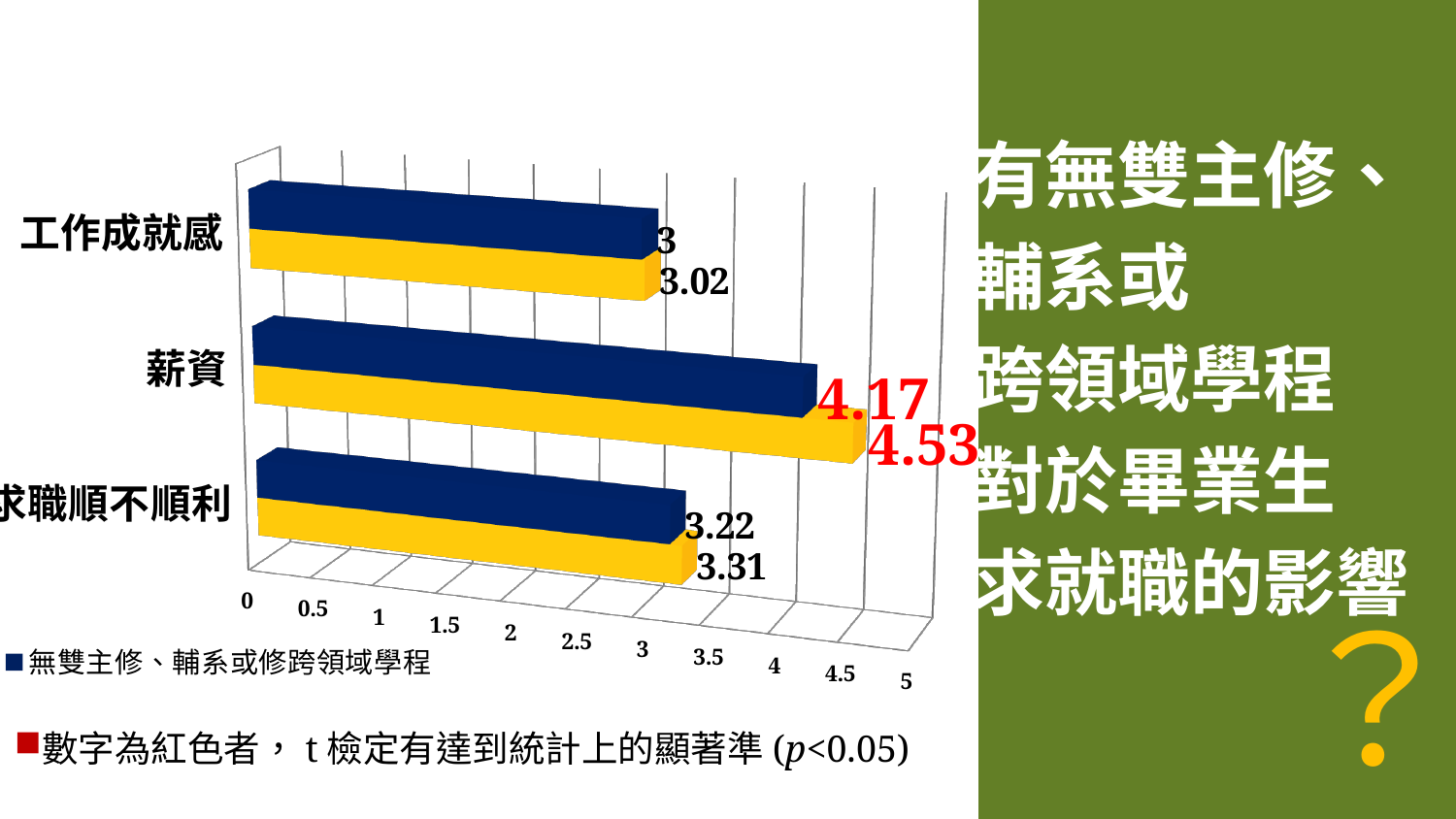
Which category has the highest value for the yellow series? 薪資 What is the value of the yellow bar for 求職順不順利? 3.31 What is the difference between the yellow bar and the dark blue bar for 薪資? 0.36 What is the value of the 無雙主修、輔系或修跨領域學程 (dark blue) bar for 薪資? 4.17 Which is larger for 求職順不順利: the dark blue bar or the yellow bar? the yellow bar How many categories are plotted on the chart? 3 What is the value of the 無雙主修、輔系或修跨領域學程 (dark blue) bar for 工作成就感? 3 What is the value of the yellow bar for 工作成就感? 3.02 According to the note below the chart, what do the red numbers indicate? t 檢定有達到統計上的顯著準 (p<0.05) What type of chart is shown on the slide? bar chart What is the value of the yellow bar for 薪資? 4.53 What is the value of the 無雙主修、輔系或修跨領域學程 (dark blue) bar for 求職順不順利? 3.22